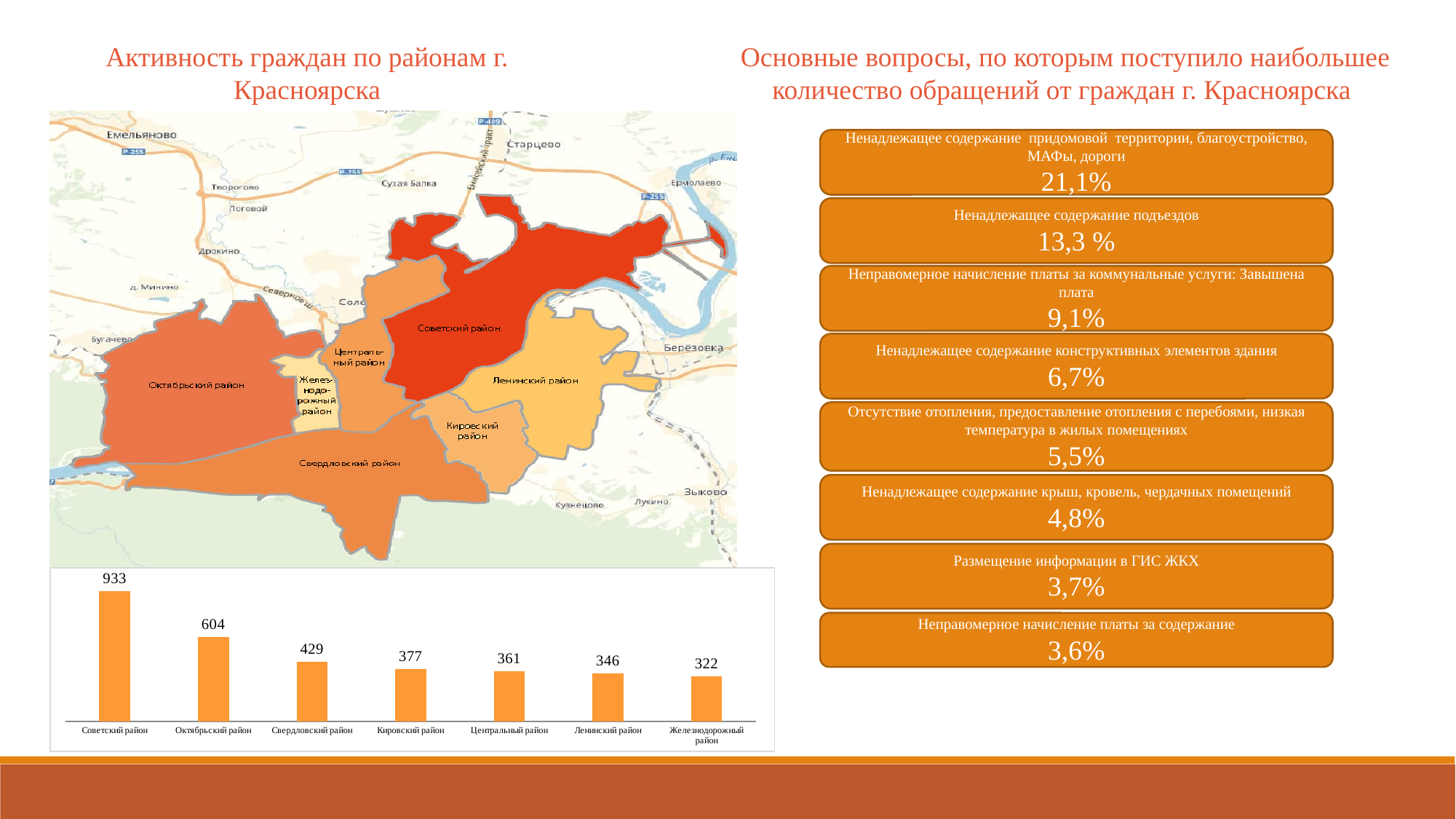
What is the value for Октябрьский район in the bar chart? 604 What is the difference between the values for Советский район and Октябрьский район in the bar chart? 329 Which district has the highest value in the bar chart? Советский район What is the value for Советский район in the bar chart? 933 What is the difference between the values for Свердловский район and Ленинский район in the bar chart? 83 Which is larger in the bar chart: the value for Центральный район or the value for Ленинский район? Центральный район Do the values in the bar chart rise or fall from left to right? Fall What is the value for Кировский район in the bar chart? 377 What kind of chart is shown at the bottom left of the slide? Bar chart How many districts are shown in the bar chart? 7 What is the value for Железнодорожный район in the bar chart? 322 Which district has the lowest value in the bar chart? Железнодорожный район